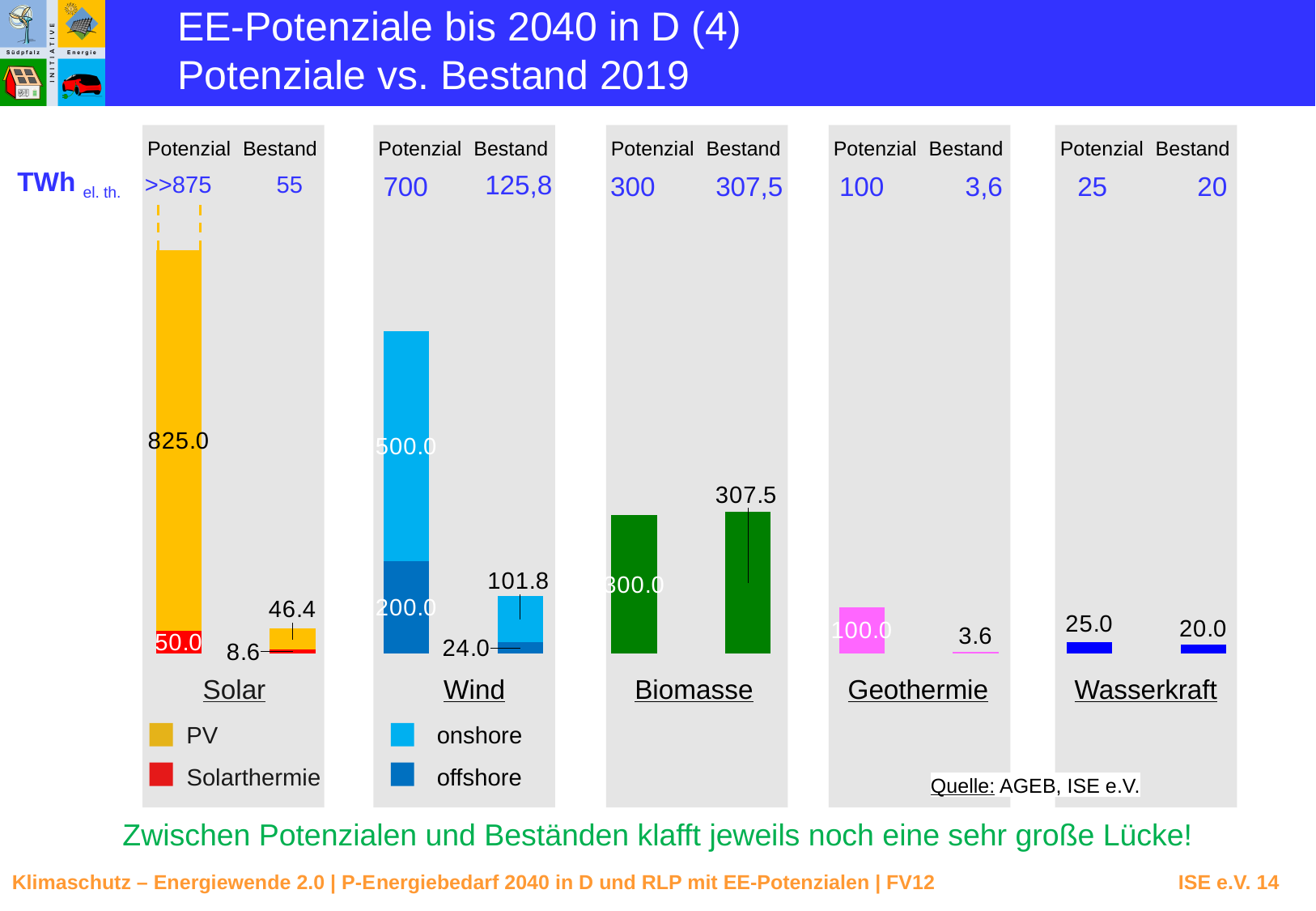
In the Wind chart, what is the onshore value of the Potenzial bar? 500.0 In the Wasserkraft chart, what is the difference between the Potenzial (25.0) and Bestand (20.0) values? 5.0 What kind of chart is used in the Solar panel? Stacked bar chart In the Solar chart, what is the PV value of the Potenzial bar? 825.0 In the Geothermie chart, which is larger, the Potenzial bar or the Bestand bar? Potenzial How many series does the legend of the Wind chart list? 2 In the Biomasse chart, what is the Bestand value? 307.5 In the Geothermie chart, what is the Bestand value? 3.6 In the Biomasse chart, which is larger, the Potenzial bar or the Bestand bar? Bestand In the Wind chart, what is the total of the stacked Bestand bar (onshore 101.8 plus offshore 24.0)? 125.8 In the Solar chart, what is the Solarthermie value of the Bestand bar? 8.6 In the Wind chart, what is the offshore value of the Bestand bar? 24.0